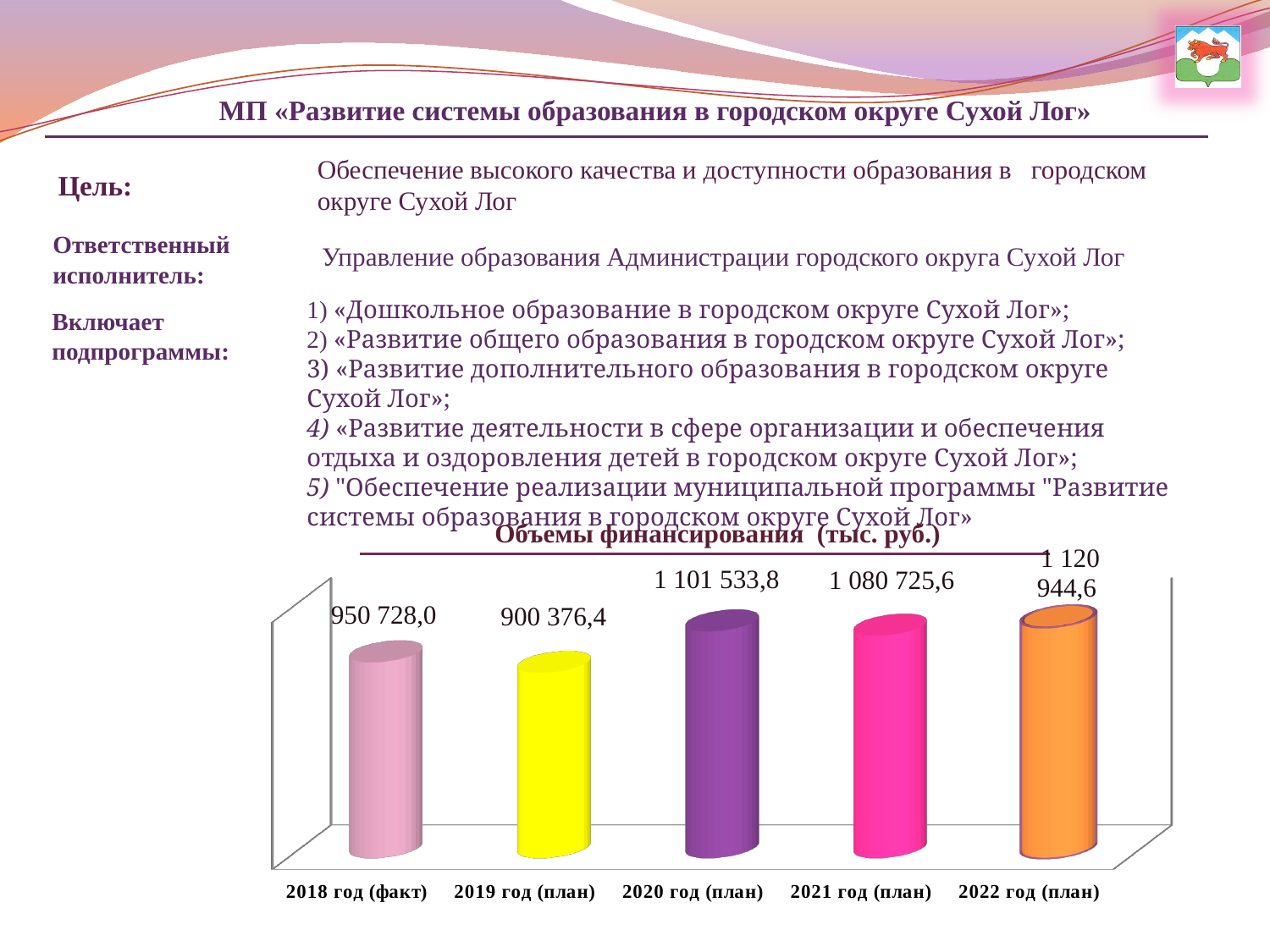
What is the value for 2022 год (план)? 1 120 944,6 What kind of chart is shown on the slide? bar chart What is the value for 2018 год (факт)? 950 728,0 Which is larger, the value for 2020 год (план) or 2021 год (план)? 2020 год (план) What is the value for 2020 год (план)? 1 101 533,8 What is the difference between the values for 2020 год (план) and 2021 год (план)? 20 808,2 What is the value for 2019 год (план)? 900 376,4 How many years are shown in the chart? 5 What is the title of the chart? Объемы финансирования (тыс. руб.) Which year has the highest funding volume? 2022 год (план) What is the difference between the values for 2022 год (план) and 2018 год (факт)? 170 216,6 Which year has the lowest funding volume? 2019 год (план)